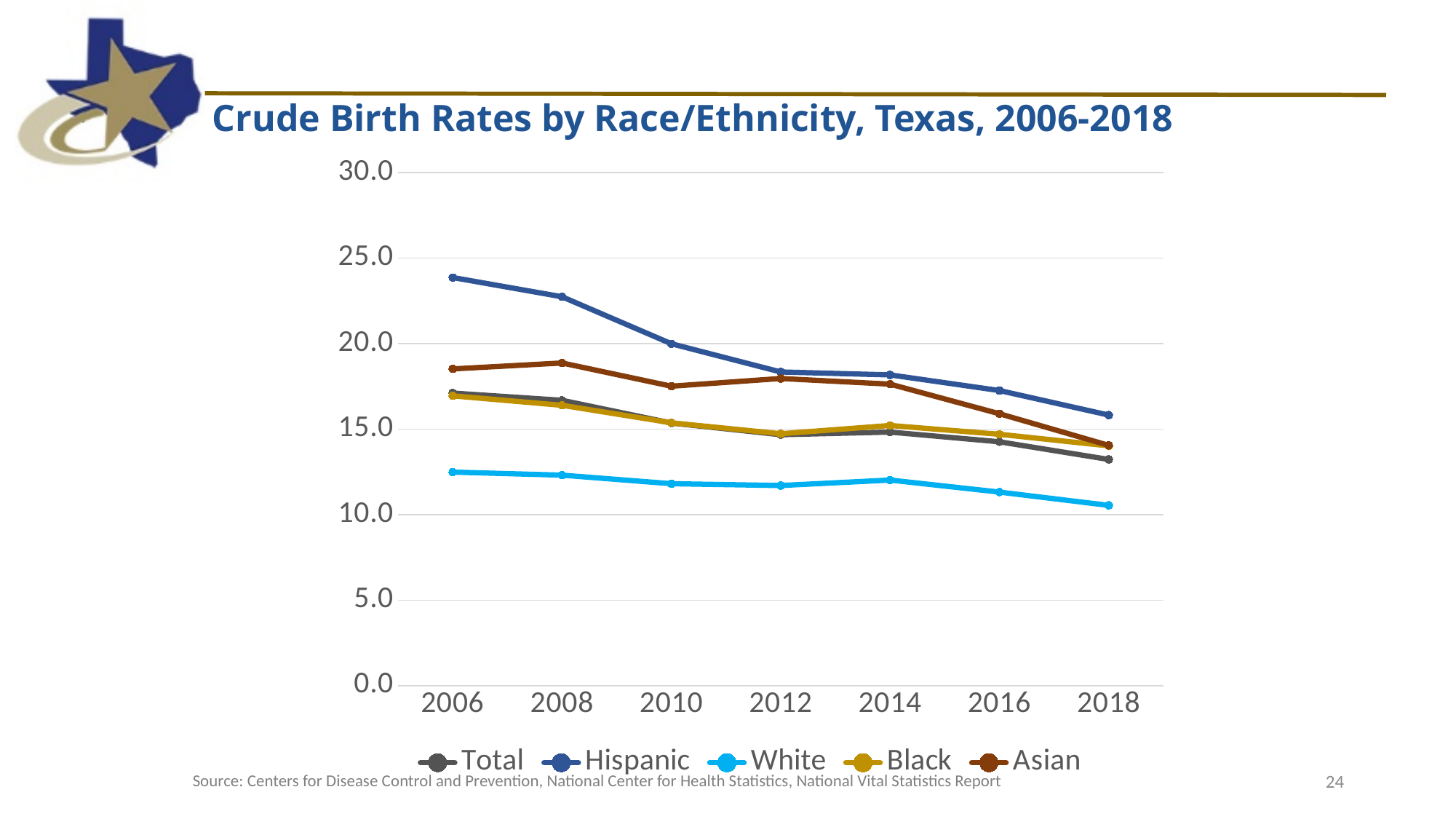
How many series does the legend list? 5 Is the value for Asian in 2008 greater or less than 20.0? less Is the value for White in 2006 greater or less than 15.0? less Which race/ethnicity group has the lowest crude birth rate in 2018? White Is the value for Total in 2018 greater or less than 15.0? less Which race/ethnicity group has the highest crude birth rate in 2006? Hispanic Does the Hispanic crude birth rate rise or fall from 2006 to 2018? fall How many years are shown on the x axis? 7 What is the title of the chart? Crude Birth Rates by Race/Ethnicity, Texas, 2006-2018 What kind of chart is shown on the slide? line chart In 2006, which is larger, the value for Asian or the value for Black? Asian